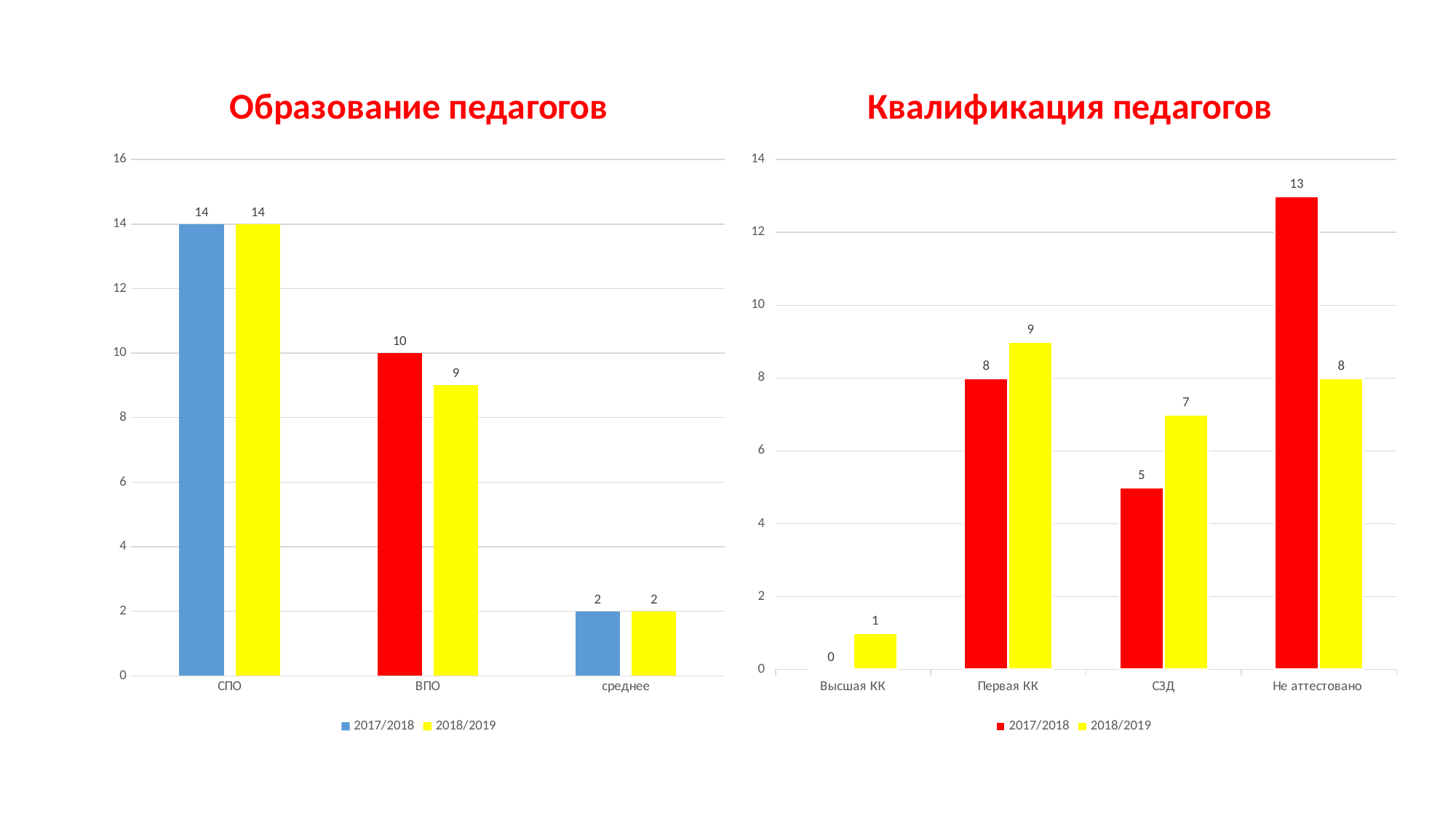
In the 'Образование педагогов' chart, what is the value for ВПО in 2018/2019? 9 In the 'Образование педагогов' chart, which category has the lowest values? среднее In the 'Квалификация педагогов' chart, what is the value for Не аттестовано in 2017/2018? 13 In the 'Квалификация педагогов' chart, what is the difference between the 2017/2018 and 2018/2019 values for Не аттестовано? 5 In the 'Образование педагогов' chart, what is the value for СПО in 2017/2018? 14 In the 'Квалификация педагогов' chart, which category has the highest 2017/2018 value? Не аттестовано How many series does the legend of the 'Квалификация педагогов' chart list? 2 What type of chart is the 'Квалификация педагогов' chart? Bar chart How many categories are shown in the 'Образование педагогов' chart? 3 In the 'Образование педагогов' chart, what is the difference between the 2017/2018 and 2018/2019 values for ВПО? 1 In the 'Квалификация педагогов' chart, what is the value for СЗД in 2018/2019? 7 In the 'Квалификация педагогов' chart, which is larger for Первая КК: the 2017/2018 value or the 2018/2019 value? 2018/2019